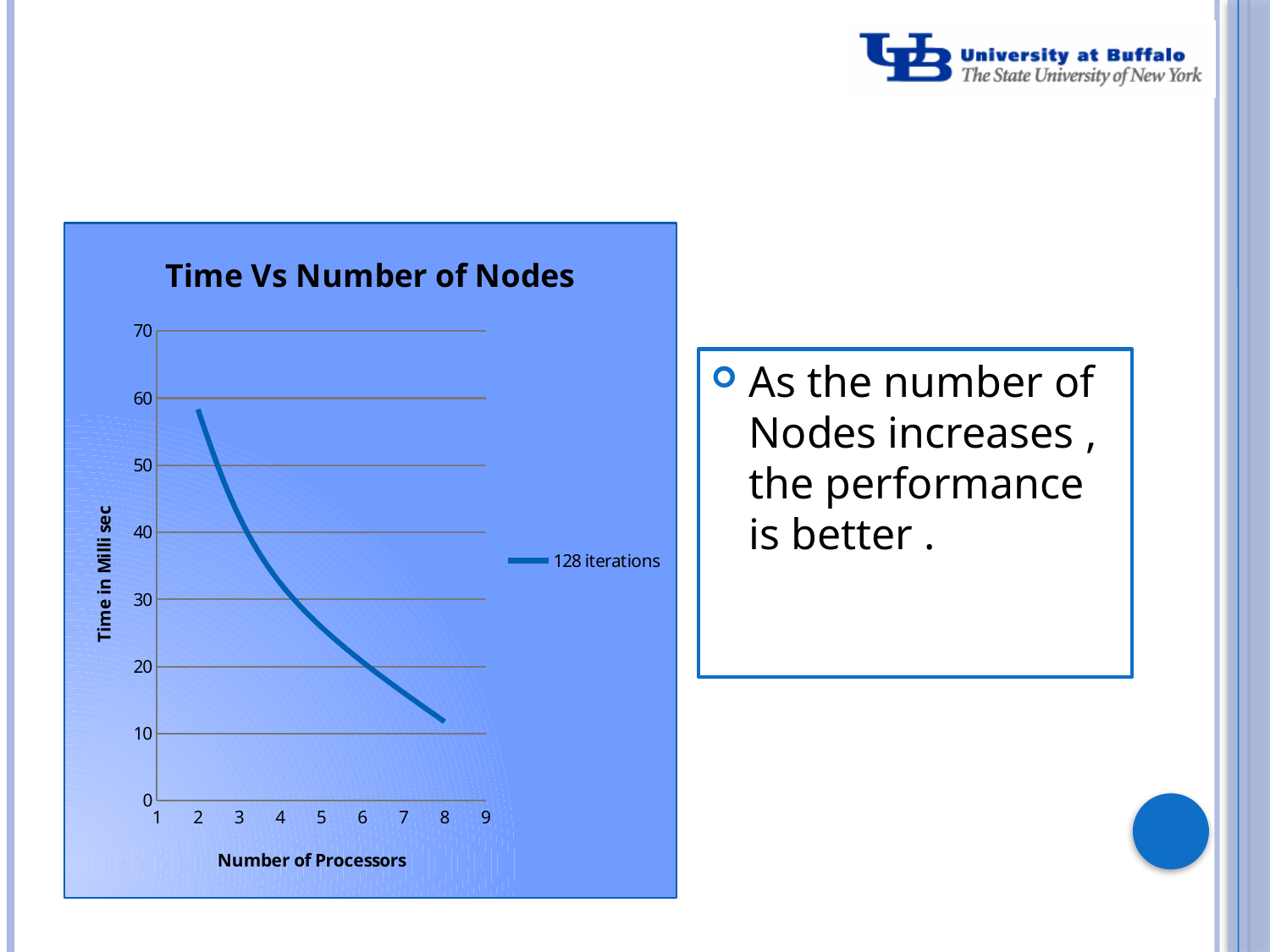
What is the title of the chart? Time Vs Number of Nodes Which is larger, the value for 2 processors or the value for 8 processors? 2 processors What kind of chart is shown on the slide? line chart Is the value for 8 processors greater or less than 10? greater Is the value for 2 processors greater or less than 60? less Is the value for 4 processors greater or less than 20? greater What is the name of the series shown in the legend? 128 iterations How many series does the chart legend list? 1 Does the time rise or fall as the number of processors increases along the x axis? fall